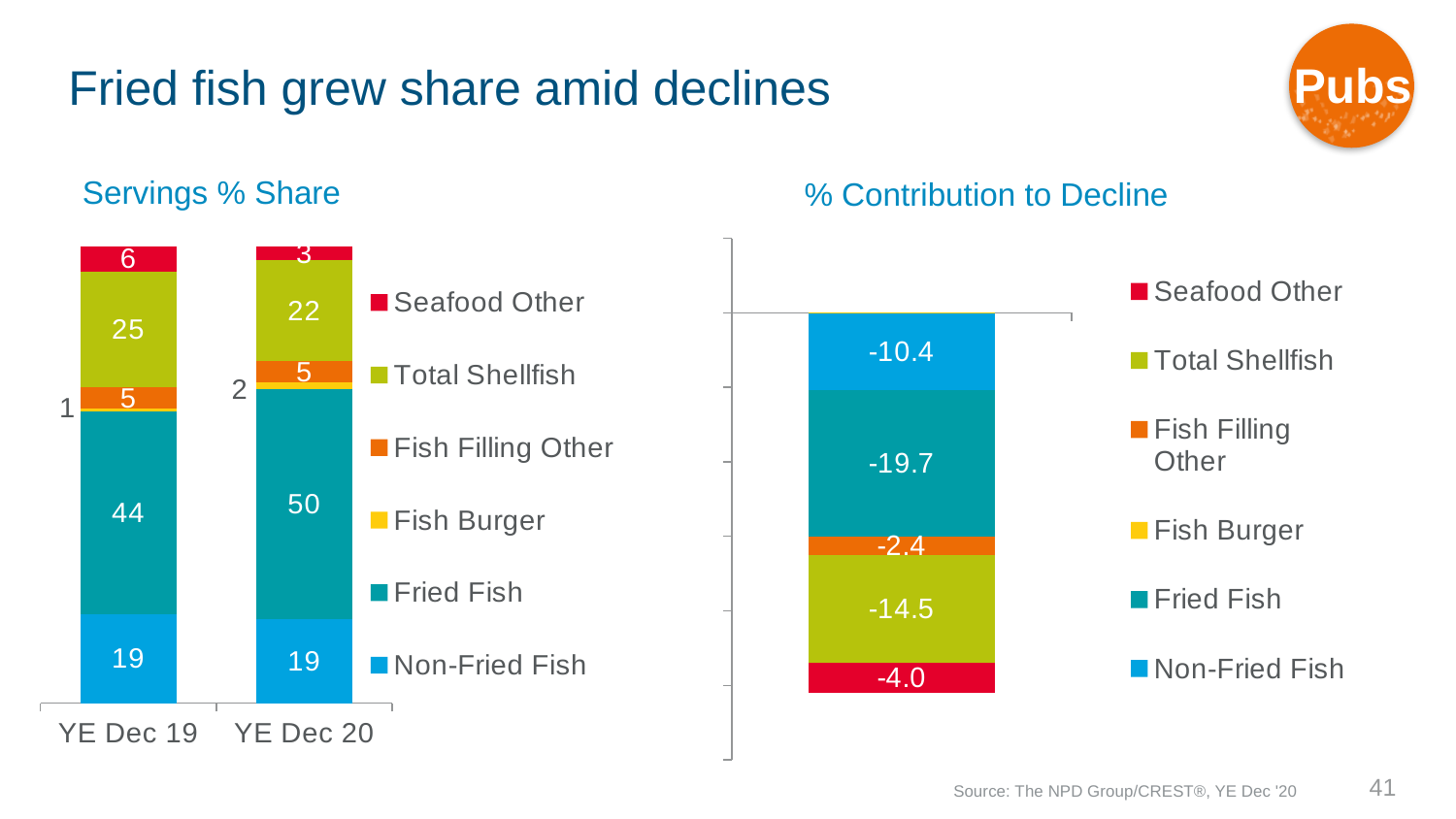
How many bars are shown in the Servings % Share chart? 2 In the Servings % Share chart, what is the total of the YE Dec 19 bar? 100 In the Servings % Share chart, what is the value for Total Shellfish in YE Dec 19? 25 In the % Contribution to Decline chart, what is the value for Total Shellfish? -14.5 In the Servings % Share chart, by how much did the Fried Fish value change from YE Dec 19 to YE Dec 20? 6 In the Servings % Share chart, what is the value for Fried Fish in YE Dec 20? 50 How many series does the legend of the Servings % Share chart list? 6 What kind of chart is the Servings % Share chart? Stacked bar chart In the Servings % Share chart, what is the value for Seafood Other in YE Dec 20? 3 In the % Contribution to Decline chart, what is the value for Fried Fish? -19.7 In the % Contribution to Decline chart, which category has the largest contribution to the decline? Fried Fish In the Servings % Share chart, which year has the larger Total Shellfish value, YE Dec 19 or YE Dec 20? YE Dec 19